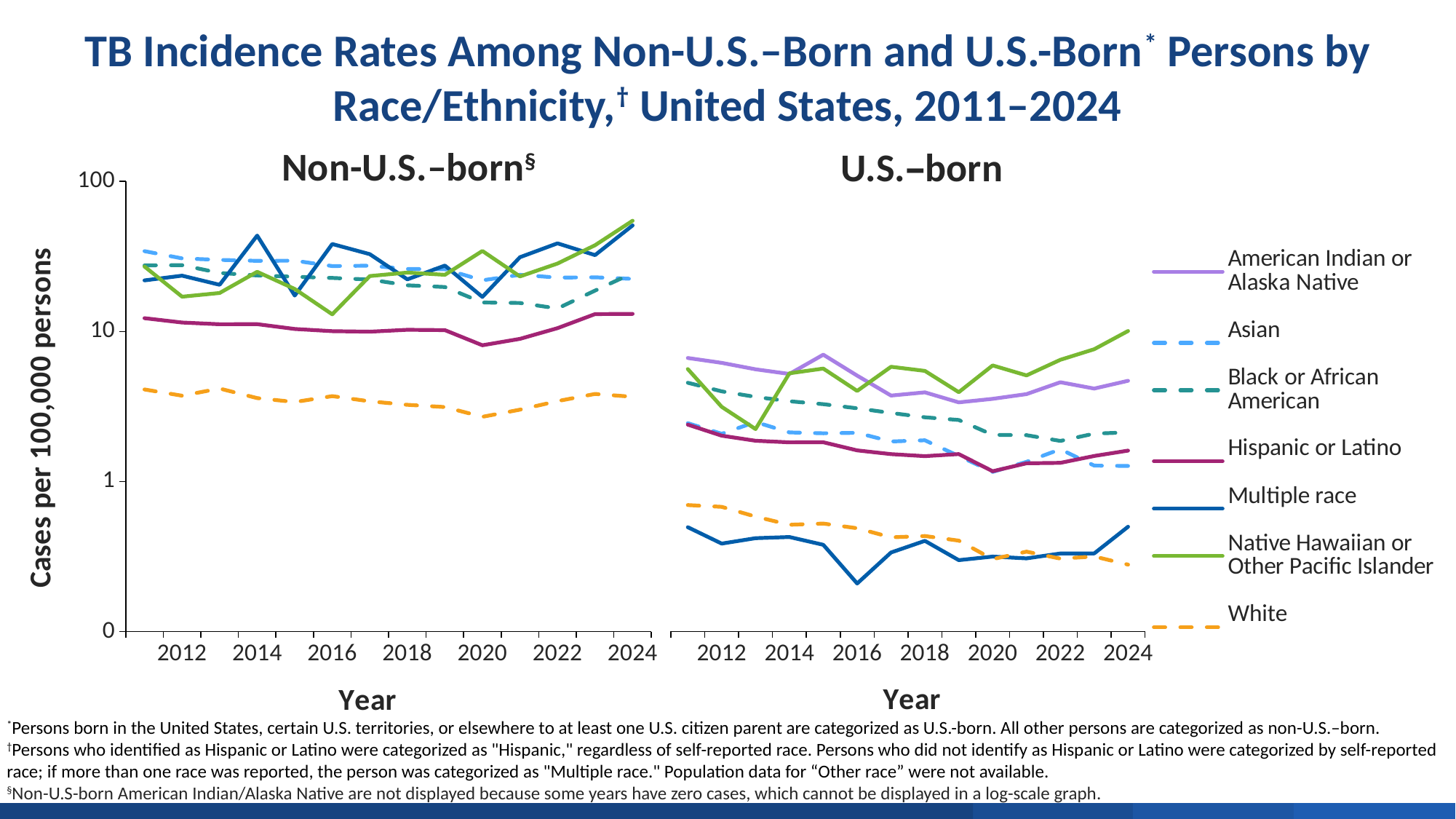
How many charts are shown on the slide? 2 In the Non-U.S.-born chart, is the value for White in 2024 greater or less than 10? less In the U.S.-born chart, is the value for White in 2024 greater or less than 1? less In the U.S.-born chart, which series has the lowest value in 2016? Multiple race In the Non-U.S.-born chart, which series has the lowest values across the whole period? White How many series does the legend list? 7 In the U.S.-born chart, which is larger in 2024: American Indian or Alaska Native, or Hispanic or Latino? American Indian or Alaska Native What kind of chart is used for the Non-U.S.-born panel? Line chart In the Non-U.S.-born chart, is the value for Asian in 2012 greater or less than 10? greater In the U.S.-born chart, does the White series rise or fall from 2011 to 2024? Fall In the U.S.-born chart, which series has the highest value in 2024? Native Hawaiian or Other Pacific Islander What is the label on the y axis? Cases per 100,000 persons